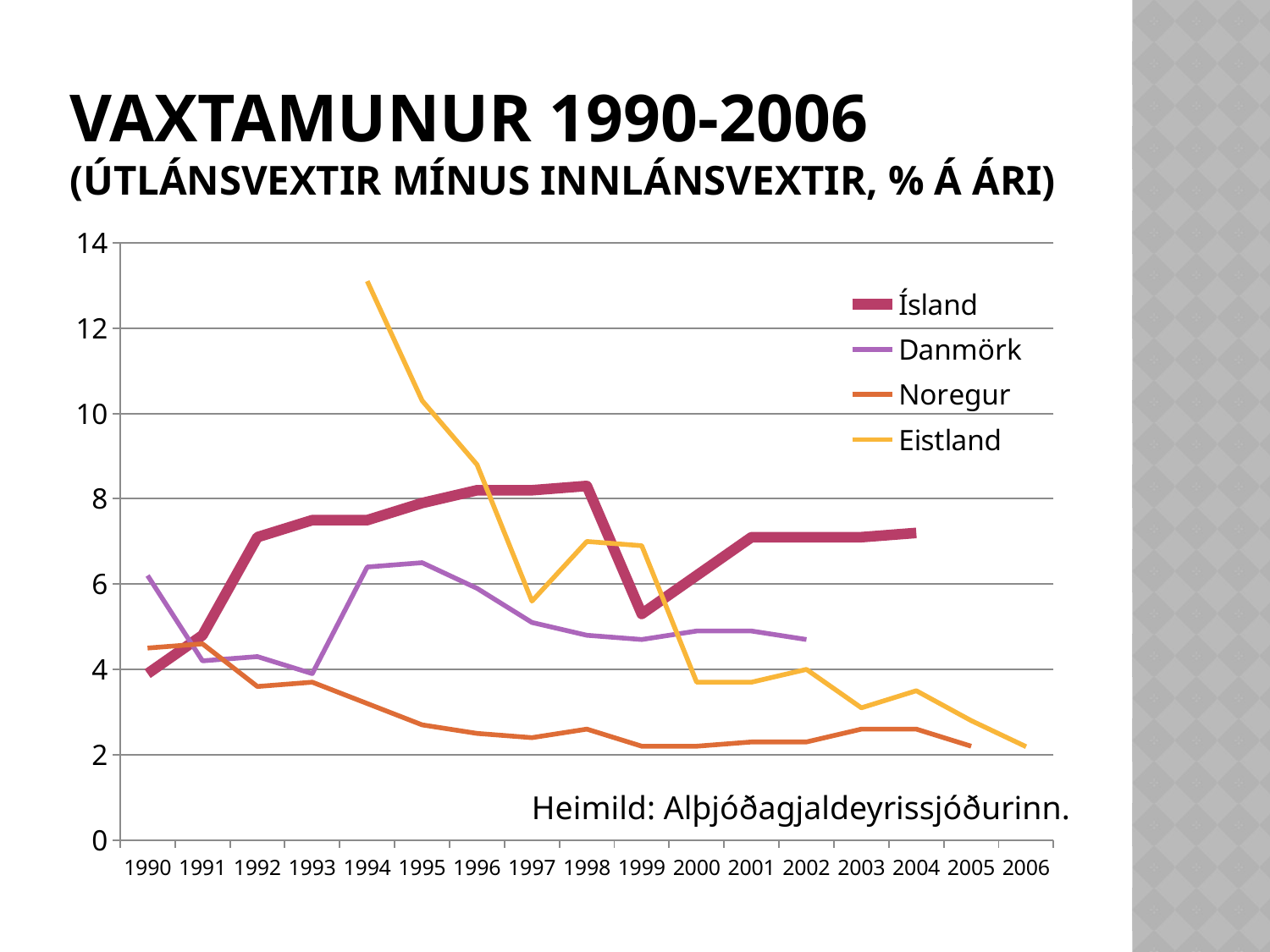
Which series reaches the highest value anywhere on the chart? Eistland Does the Eistland line rise or fall from 1994 to 2006? fall Is the value for Eistland in 1994 greater or less than 12? greater In 2000, which is larger: the value for Ísland or the value for Noregur? Ísland Which series has the lowest value in 2000? Noregur What kind of chart is shown on the slide? line chart Which series is drawn with the thickest line? Ísland How many years are shown along the x axis? 17 How many series does the legend list? 4 Is the value for Ísland in 1998 greater or less than 8? greater Is the value for Ísland in 1999 greater or less than 6? less